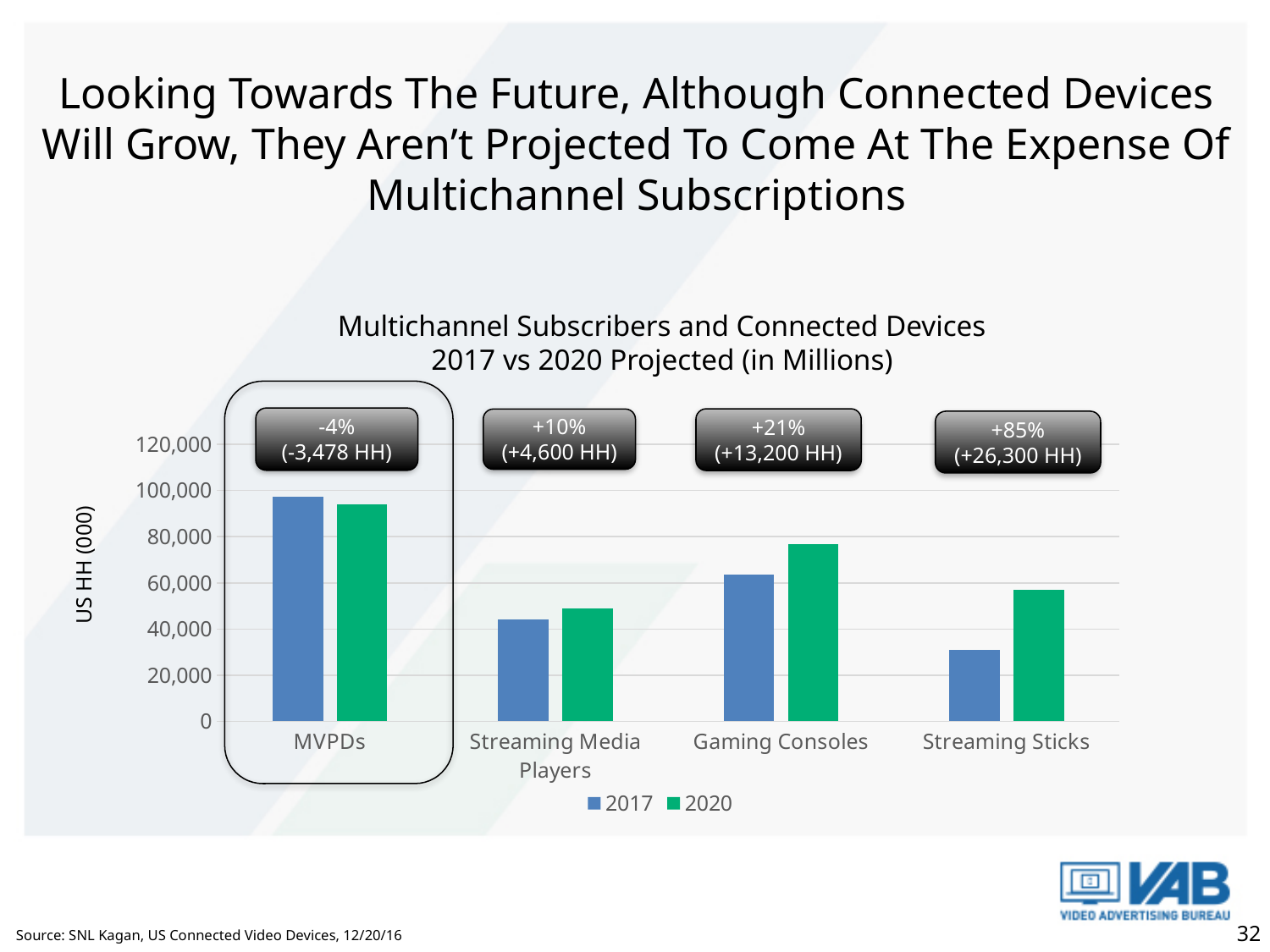
For Gaming Consoles, which is larger, the 2017 value or the 2020 value? 2020 How many series does the chart legend list? 2 What percentage change is shown in the callout above the Gaming Consoles bars? +21% Is the 2020 value for Streaming Sticks greater or less than 40,000? greater Is the 2017 value for Gaming Consoles greater or less than 80,000? less How many device categories are shown on the x axis of the chart? 4 What are the two series listed in the chart legend? 2017 and 2020 Which category has the highest 2017 value? MVPDs What percentage change is shown in the callout above the MVPDs bars? -4% What kind of chart is shown on the slide? bar chart What household change is shown in the callout above the Streaming Sticks bars? +26,300 HH Which category has the lowest 2017 value? Streaming Sticks